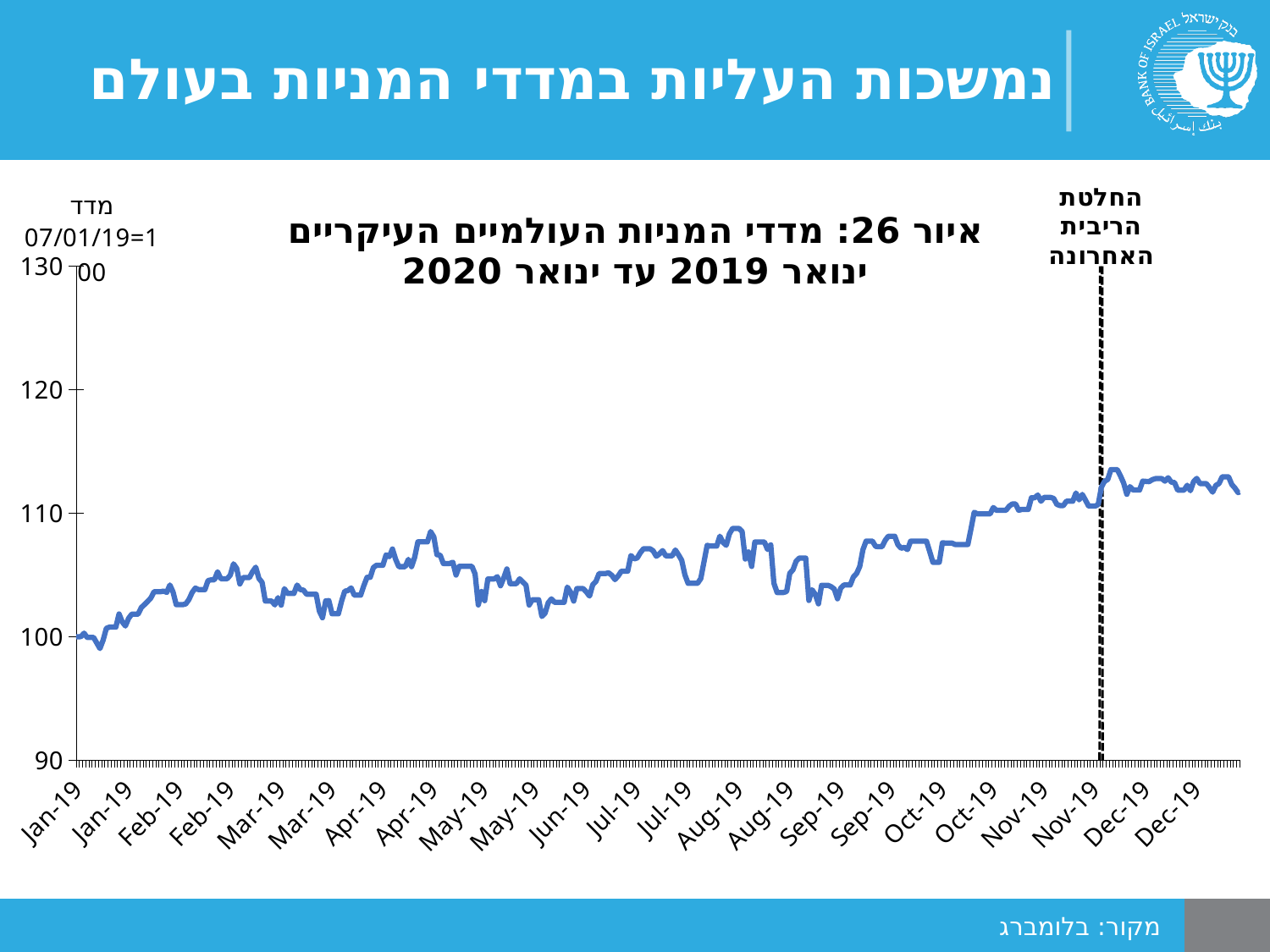
Overall, do the values rise or fall from Jan-19 to Dec-19? Rise Is the value of the index in Dec-19 greater or less than 110? greater What is the highest tick value shown on the vertical axis? 130 How many data series are plotted in the chart? 1 What is the title of the chart? איור 26: מדדי המניות העולמיים העיקריים ינואר 2019 עד ינואר 2020 Which is higher, the index value in Dec-19 or in Jan-19? Dec-19 Is the value of the index in Aug-19 greater or less than 110? less What kind of chart is shown on the slide? Line chart Is the value of the index at the start of Jan-19 greater or less than 110? less